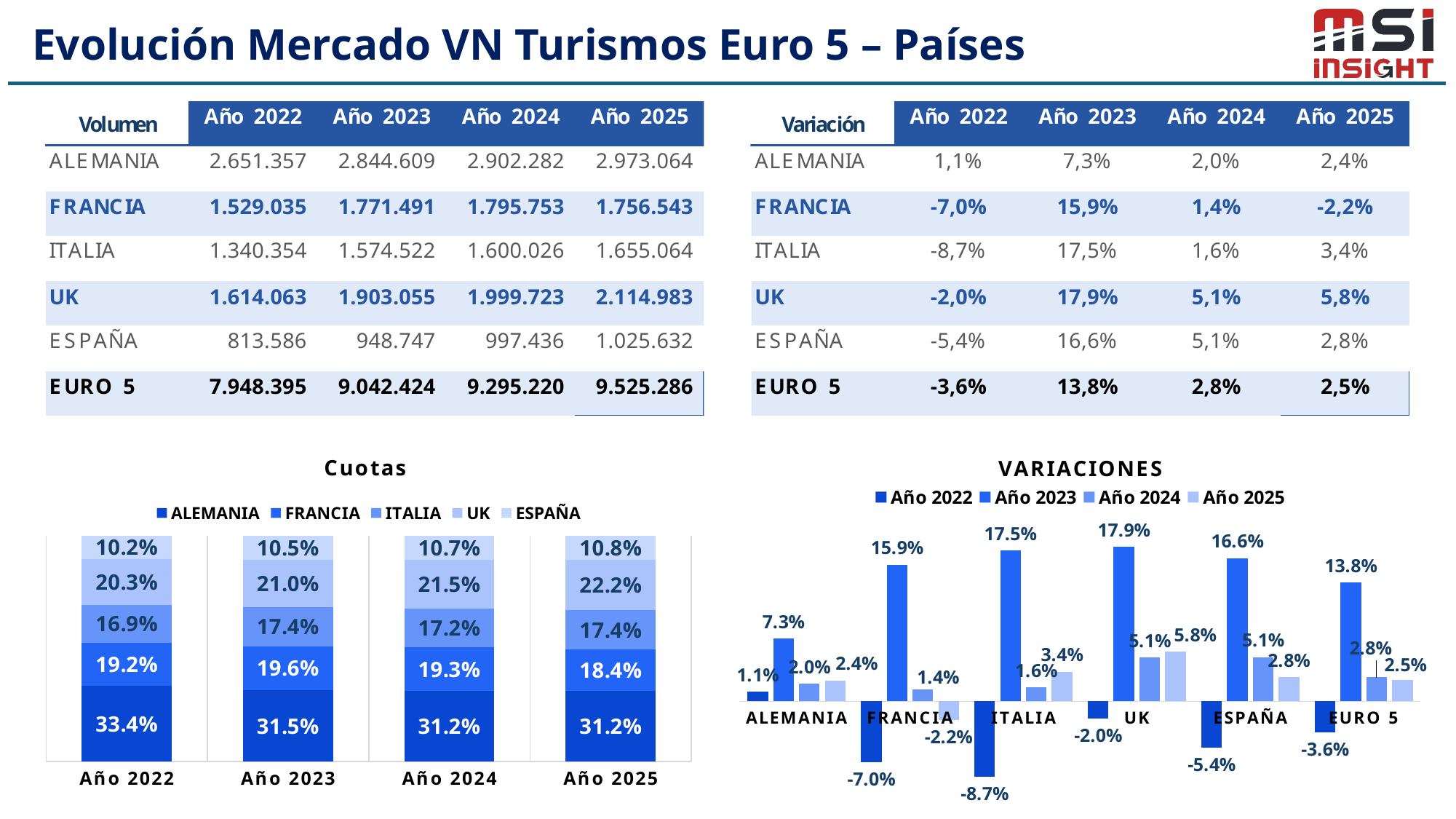
In the VARIACIONES chart, what is the Año 2023 value for UK? 17.9% In the Cuotas chart, does the UK share rise or fall from Año 2022 to Año 2025? Rises In the VARIACIONES chart, which country has the lowest Año 2022 value? ITALIA How many series does the legend of the VARIACIONES chart list? 4 In the VARIACIONES chart, which category has the highest Año 2023 value? UK In the VARIACIONES chart, which is larger for ESPAÑA: the Año 2024 value or the Año 2025 value? Año 2024 In the Cuotas chart, by how many percentage points does the ESPAÑA share in Año 2025 exceed its share in Año 2022? 0.6 percentage points In the Cuotas chart, what is the share for UK in Año 2025? 22.2% How many series does the legend of the Cuotas chart list? 5 How many categories are shown on the x axis of the VARIACIONES chart? 6 In the Cuotas chart, what is the share for ALEMANIA in Año 2022? 33.4% What kind of chart is the Cuotas chart? Stacked bar chart